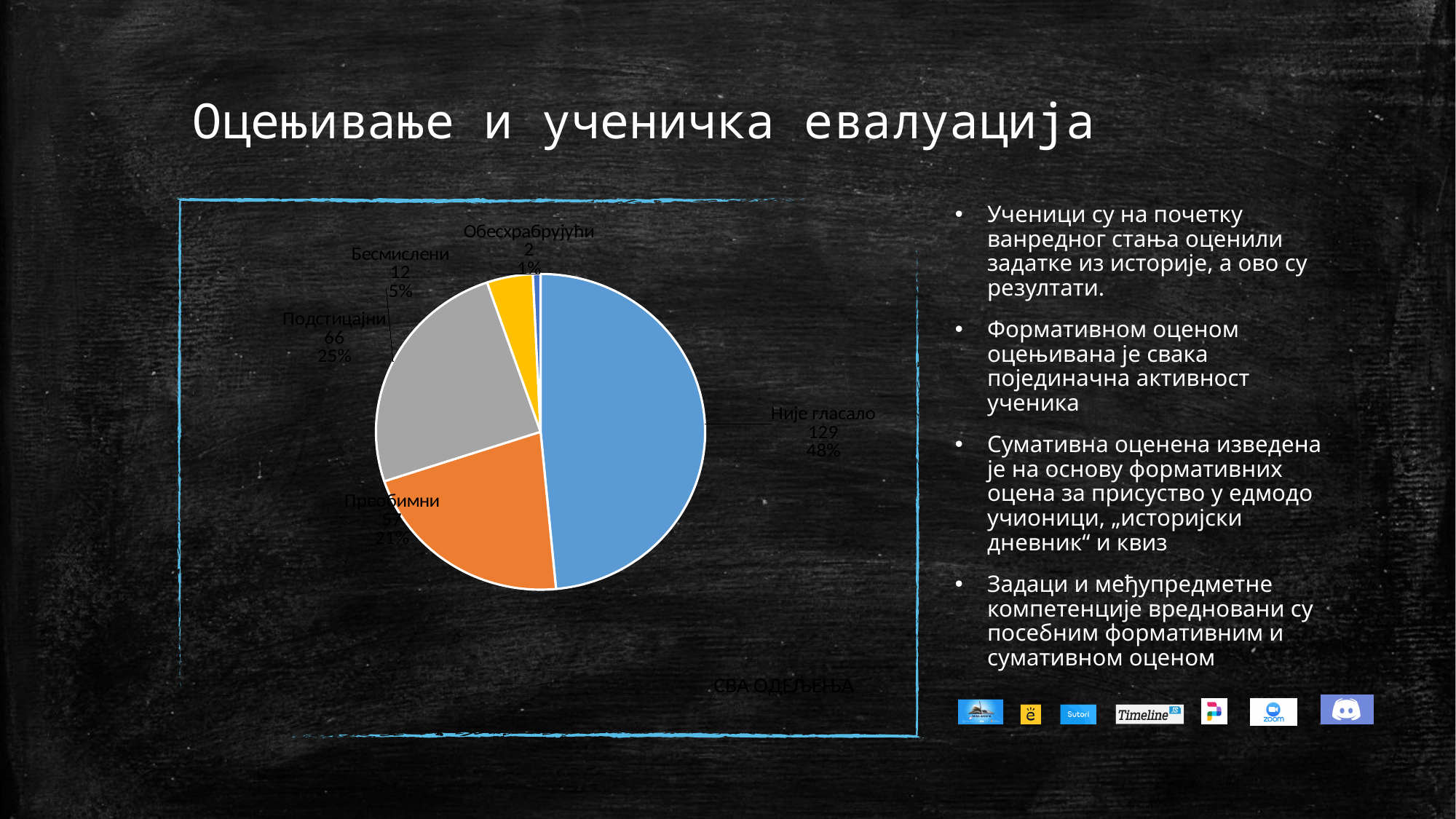
What share of the pie does Није гласало take? 48% What is the difference between the values for Подстицајни and Бесмислени? 54 How many slices does the pie chart have? 5 What kind of chart is shown on the slide? pie chart What is the value for Подстицајни? 66 What is the value for Обесхрабрујући? 2 What is the title of the pie chart? СВА ОДЕЉЕЊА Which category has the smallest slice? Обесхрабрујући What is the value for Бесмислени? 12 Which category has the largest slice? Није гласало What share of the pie does Преобимни take? 21% What is the value for Није гласало? 129